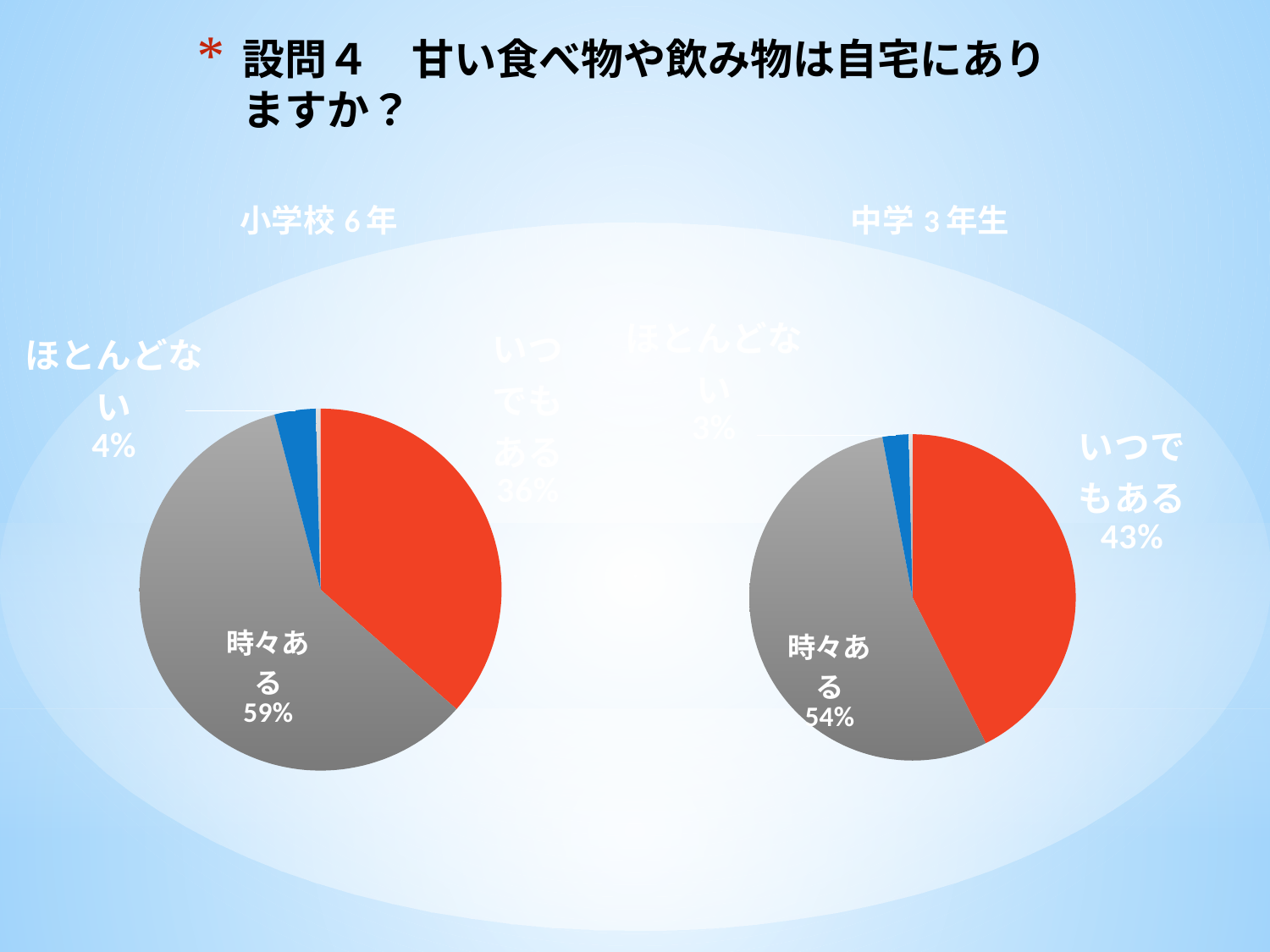
In the 中学 3年生 chart, what percentage is shown for 時々ある? 54% In the 中学 3年生 chart, what percentage is shown for ほとんどない? 3% What type of chart is used for the 小学校 6年 data? Pie chart Which chart shows a larger share for いつでもある, 小学校 6年 or 中学 3年生? 中学 3年生 In the 小学校 6年 chart, what percentage is shown for いつでもある? 36% What is the difference between the 時々ある share in the 小学校 6年 chart and the 時々ある share in the 中学 3年生 chart? 5% In the 中学 3年生 chart, what percentage is shown for いつでもある? 43% In the 小学校 6年 chart, which category has the largest share? 時々ある In the 小学校 6年 chart, what percentage is shown for ほとんどない? 4% How many categories does the 中学 3年生 chart show? 3 In the 小学校 6年 chart, what percentage is shown for 時々ある? 59% In the 中学 3年生 chart, which category has the smallest share? ほとんどない